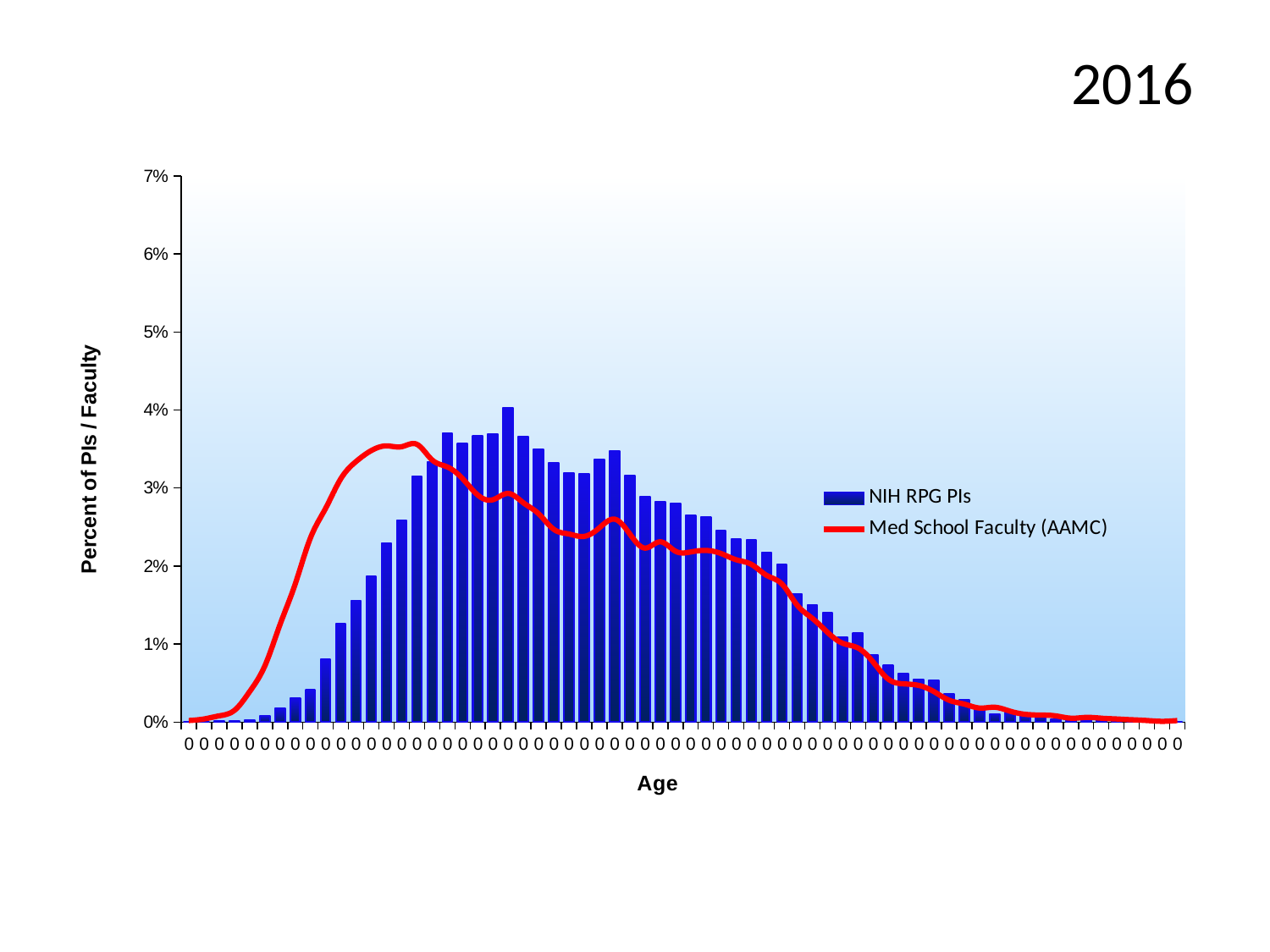
Are the bars at the far right of the x axis greater or less than 1%? less Which series reaches a higher peak value, NIH RPG PIs or Med School Faculty (AAMC)? NIH RPG PIs How many series does the legend list? 2 What year is shown as the slide title? 2016 Is the tallest NIH RPG PIs bar greater or less than 3%? greater What are the two series named in the legend? NIH RPG PIs and Med School Faculty (AAMC) What kind of chart is this? A bar chart with a line overlay Toward the right end of the x axis, do the NIH RPG PIs bar values rise or fall? fall Is the peak of the Med School Faculty (AAMC) line greater or less than 4%? less